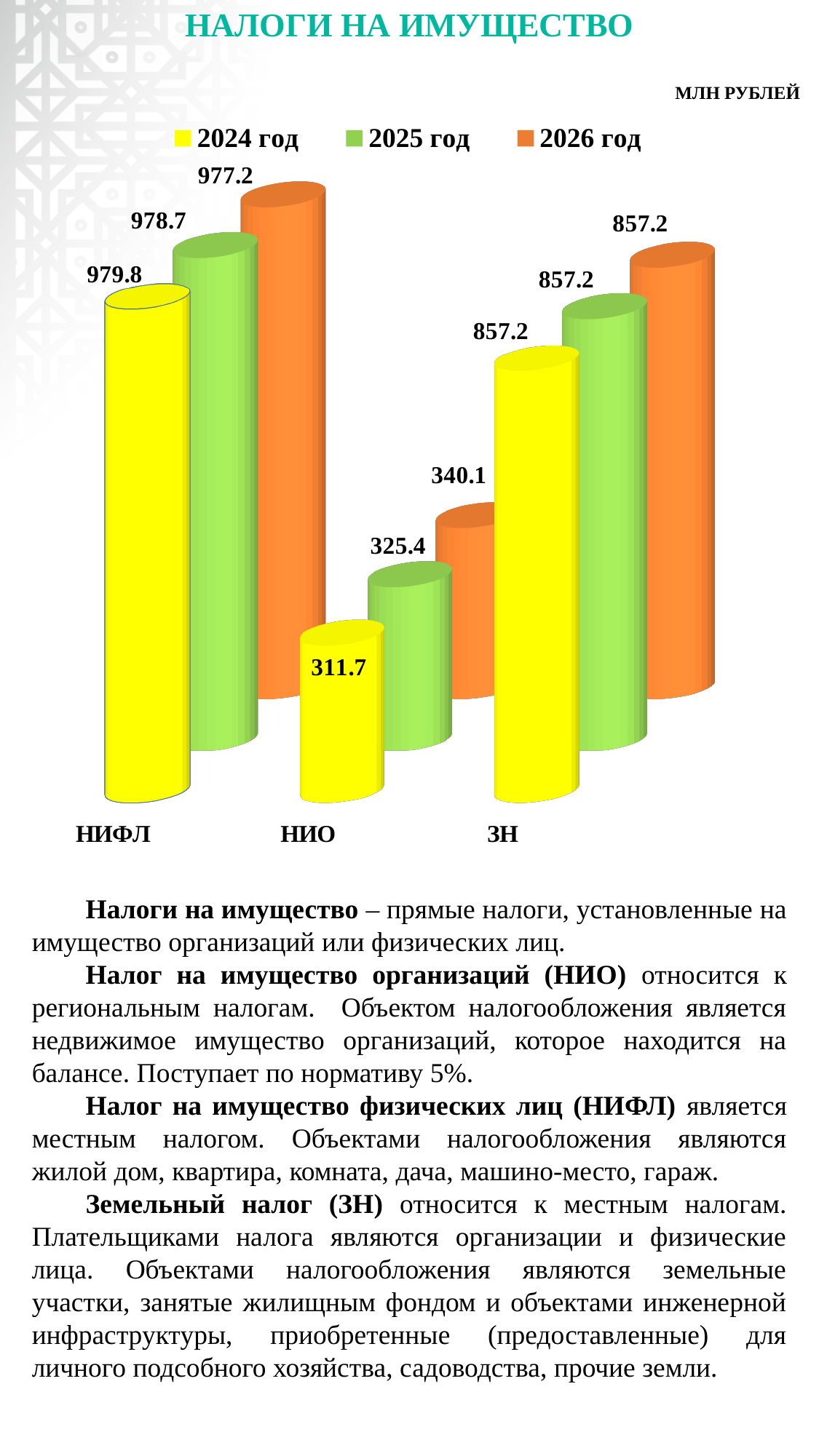
What is the value for ЗН in 2025 год? 857.2 Which is larger for НИО: the 2024 год value or the 2025 год value? 2025 год Which category has the highest value in 2026 год? НИФЛ What is the value for НИФЛ in 2024 год? 979.8 What is the difference between the 2024 год values for НИФЛ and ЗН? 122.6 What is the value for НИО in 2025 год? 325.4 What is the difference between the 2026 год and 2024 год values for НИО? 28.4 Which category has the lowest value in 2024 год? НИО How many series does the legend list? 3 What is the value for НИО in 2026 год? 340.1 Do the values for НИО rise or fall from 2024 год to 2026 год? rise How many categories are shown on the x axis? 3